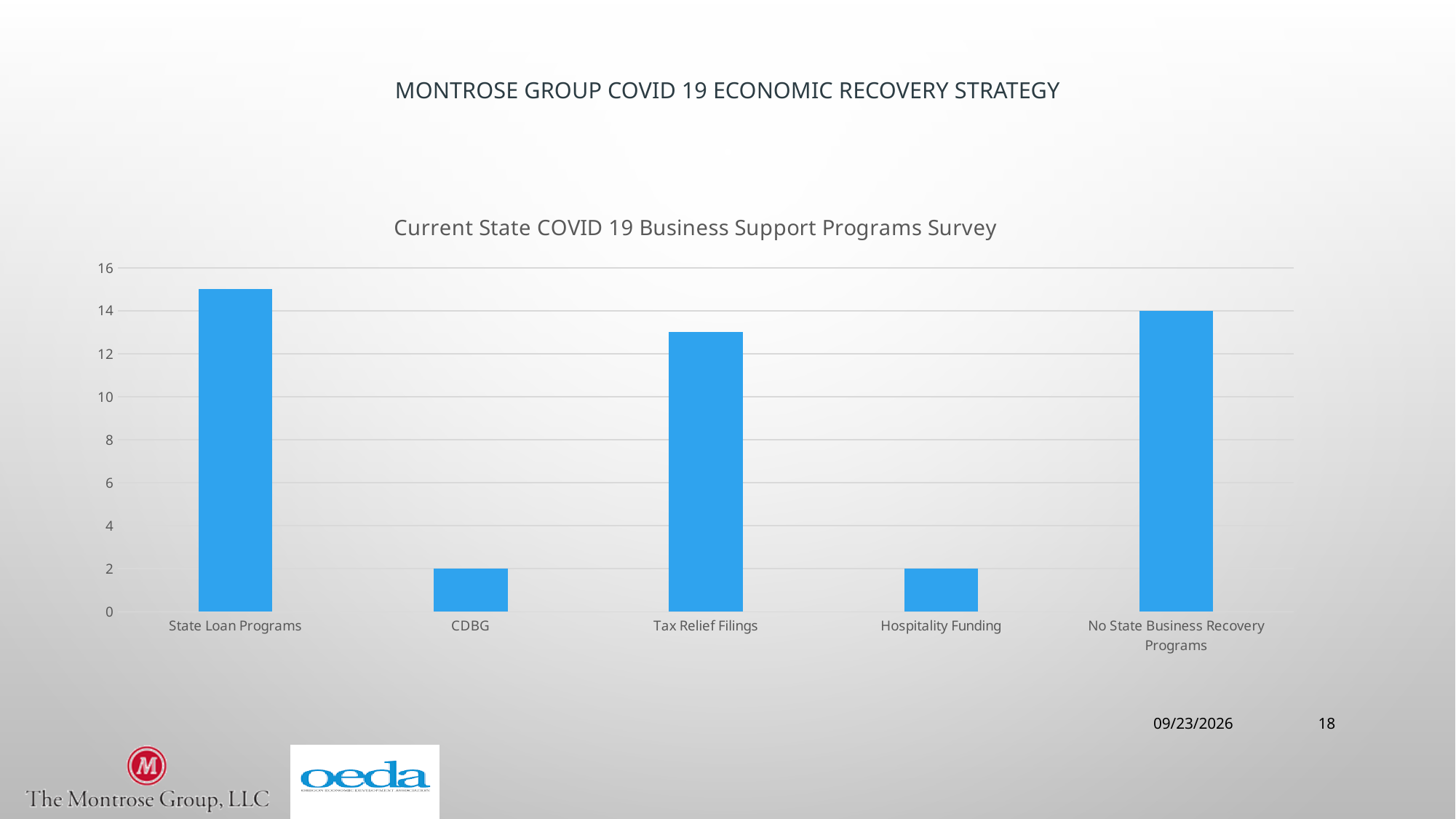
Is the value for Tax Relief Filings greater or less than 14? less Which category has the highest value? State Loan Programs What is the value for No State Business Recovery Programs? 14 What is the difference between the value for No State Business Recovery Programs and the value for CDBG? 12 What is the value for CDBG? 2 What kind of chart is shown on the slide? bar chart Is the value for State Loan Programs greater or less than 14? greater Is the value for Tax Relief Filings greater or less than 12? greater How many categories are shown on the x axis of the chart? 5 What is the value for Hospitality Funding? 2 What is the title of the chart? Current State COVID 19 Business Support Programs Survey Which is larger, the value for State Loan Programs or the value for Tax Relief Filings? State Loan Programs